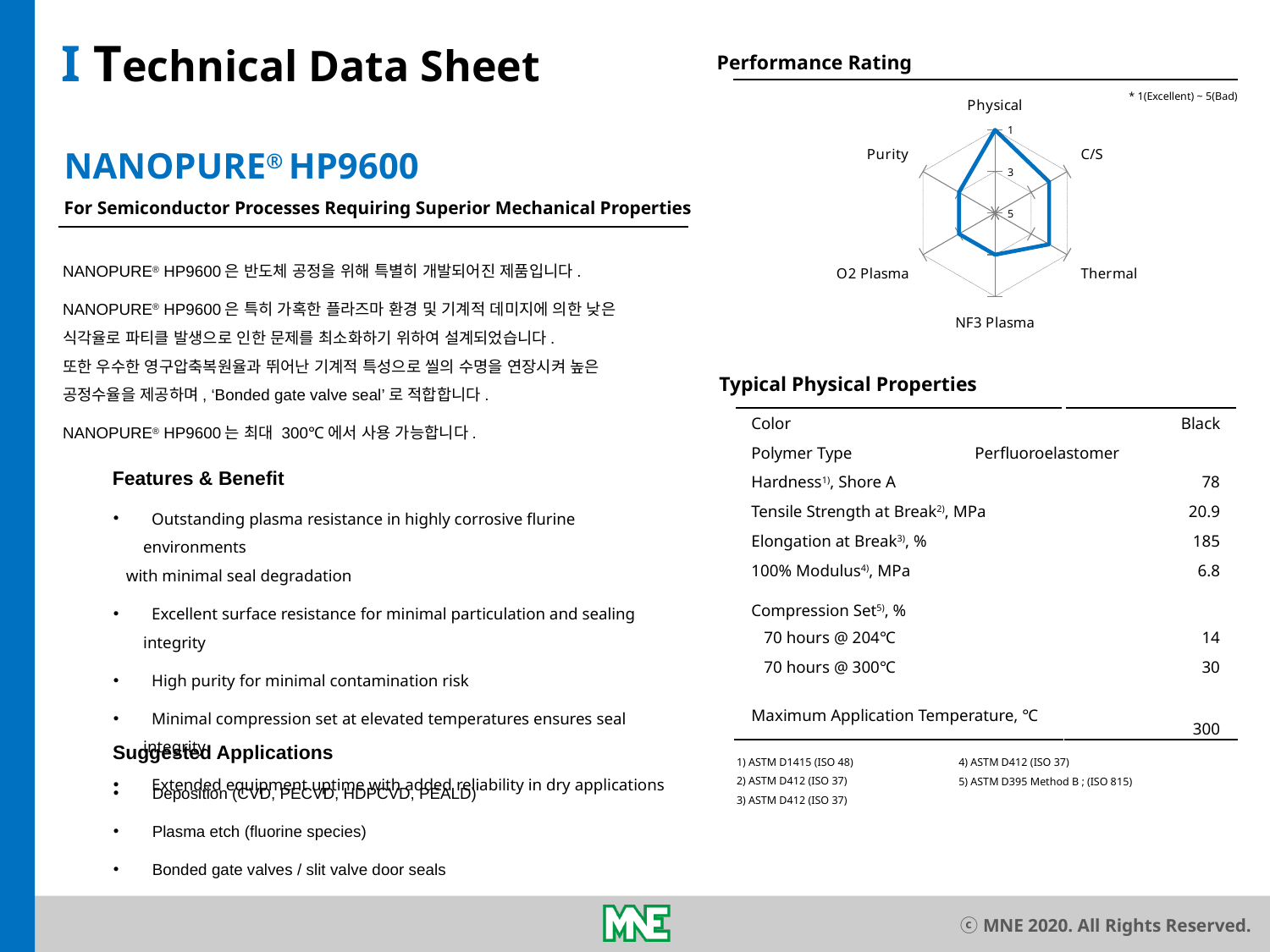
According to the note on the Performance Rating chart, what rating scale is used? 1(Excellent) ~ 5(Bad) In the Performance Rating chart, which category has the lowest (best) rating? Physical Which category is plotted at the bottom axis of the Performance Rating chart? NF3 Plasma What kind of chart is shown under the Performance Rating heading? Radar chart In the Performance Rating chart, what rating does Physical receive? 1 How many data series are plotted in the Performance Rating chart? 1 What is the title of the chart on the slide? Performance Rating In the Performance Rating chart, is the value for Thermal greater or less than 3? less In the Performance Rating chart, which has the lower rating value, Physical or NF3 Plasma? Physical How many categories (axes) does the Performance Rating radar chart have? 6 In the Performance Rating chart, is the value for C/S greater or less than 3? less